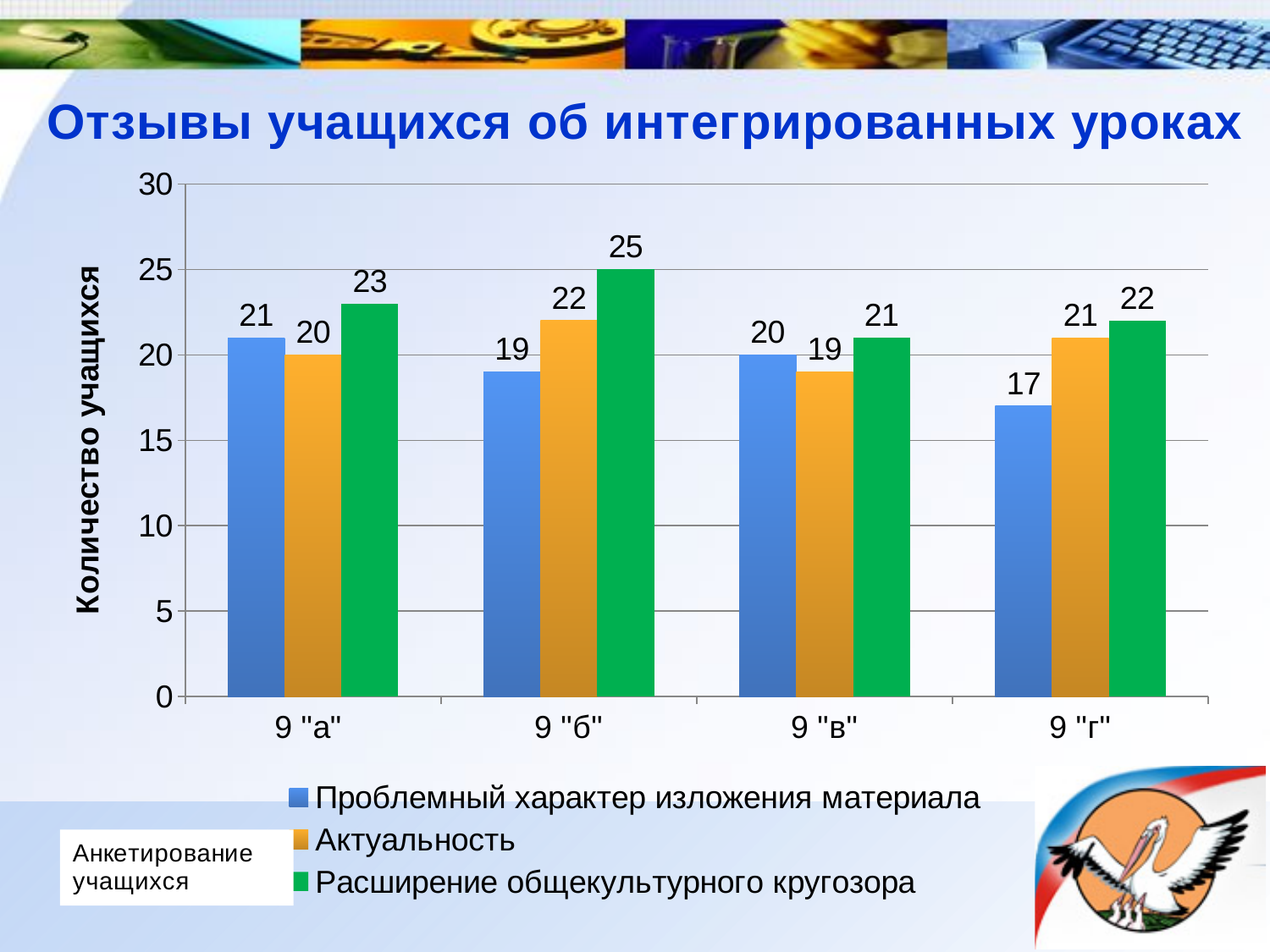
What is the value for "Актуальность" in class 9 "б"? 22 What is the value for "Расширение общекультурного кругозора" in class 9 "а"? 23 What is the label of the y axis? Количество учащихся What is the value for "Проблемный характер изложения материала" in class 9 "г"? 17 In class 9 "в", which is larger: "Проблемный характер изложения материала" or "Актуальность"? Проблемный характер изложения материала Which class has the lowest value for "Проблемный характер изложения материала"? 9 "г" Is the value for "Расширение общекультурного кругозора" in class 9 "б" greater or less than 20? greater How many series does the legend list? 3 What kind of chart is shown on the slide? bar chart How many classes are shown on the x axis? 4 Which class has the highest value for "Расширение общекультурного кругозора"? 9 "б" What is the difference between "Расширение общекультурного кругозора" and "Проблемный характер изложения материала" in class 9 "б"? 6